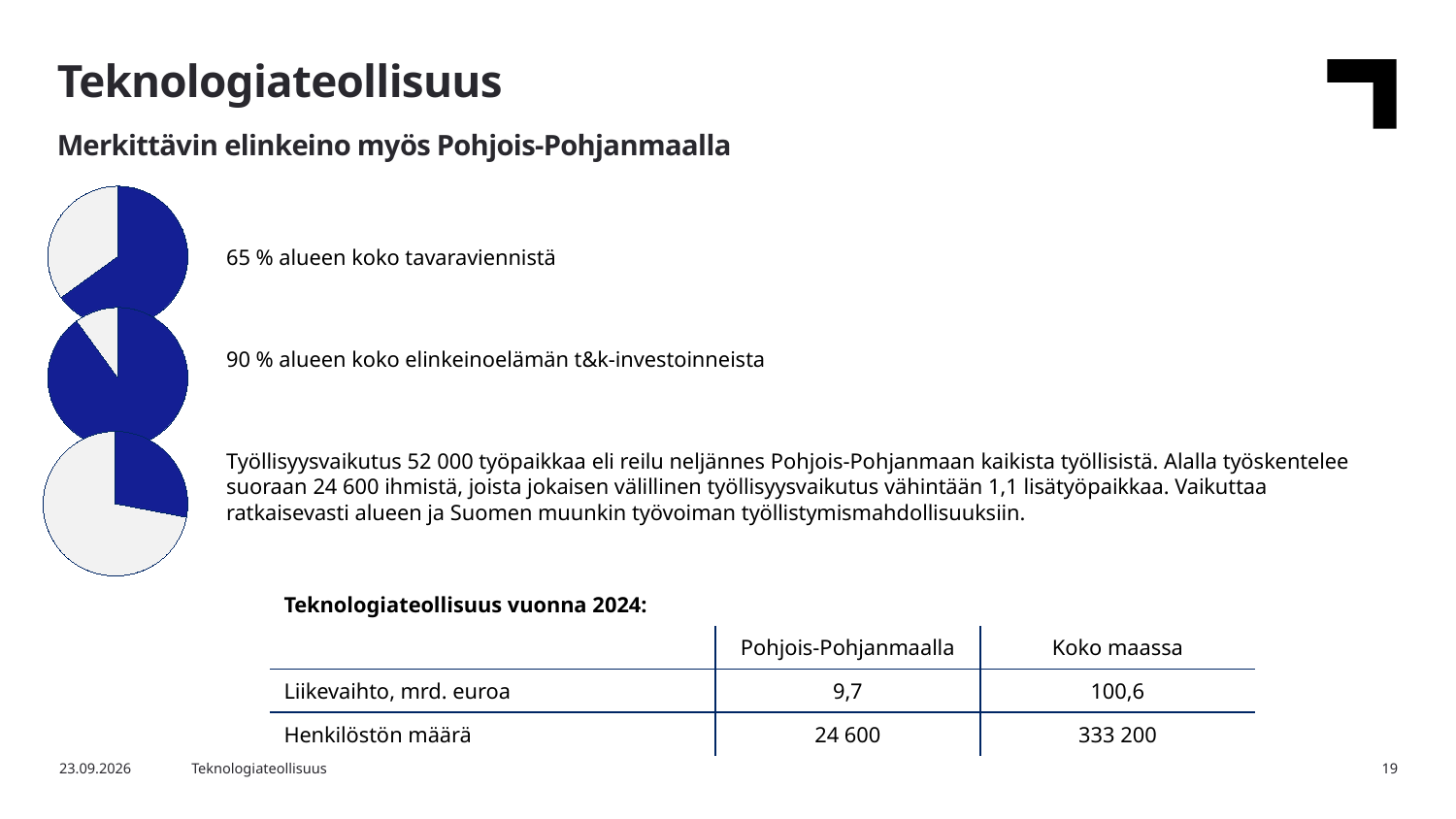
Which of the three pie charts has the smallest blue slice? the bottom pie chart Is the blue slice larger in the top pie chart or in the middle pie chart? the middle pie chart In the bottom pie chart, is the blue slice greater or less than half of the pie? less In the top pie chart, what share of the region's total goods exports (tavaravienti) does the blue slice represent? 65 % What colour is used for the highlighted slice in each pie chart? dark blue In the middle pie chart, what share of the region's business R&D investments (t&k-investoinnit) does the blue slice represent? 90 % How many pie charts are on the slide? 3 What does the bottom pie chart illustrate, according to the text next to it? the employment effect: just over a quarter of all employed people in Pohjois-Pohjanmaa Which of the three pie charts has the largest blue slice? the middle pie chart (90 %) In the top pie chart, is the blue slice greater or less than half of the pie? greater What is the difference in percentage points between the shares shown by the middle pie chart and the top pie chart? 25 percentage points What kind of chart is shown on the left side of the slide? pie chart